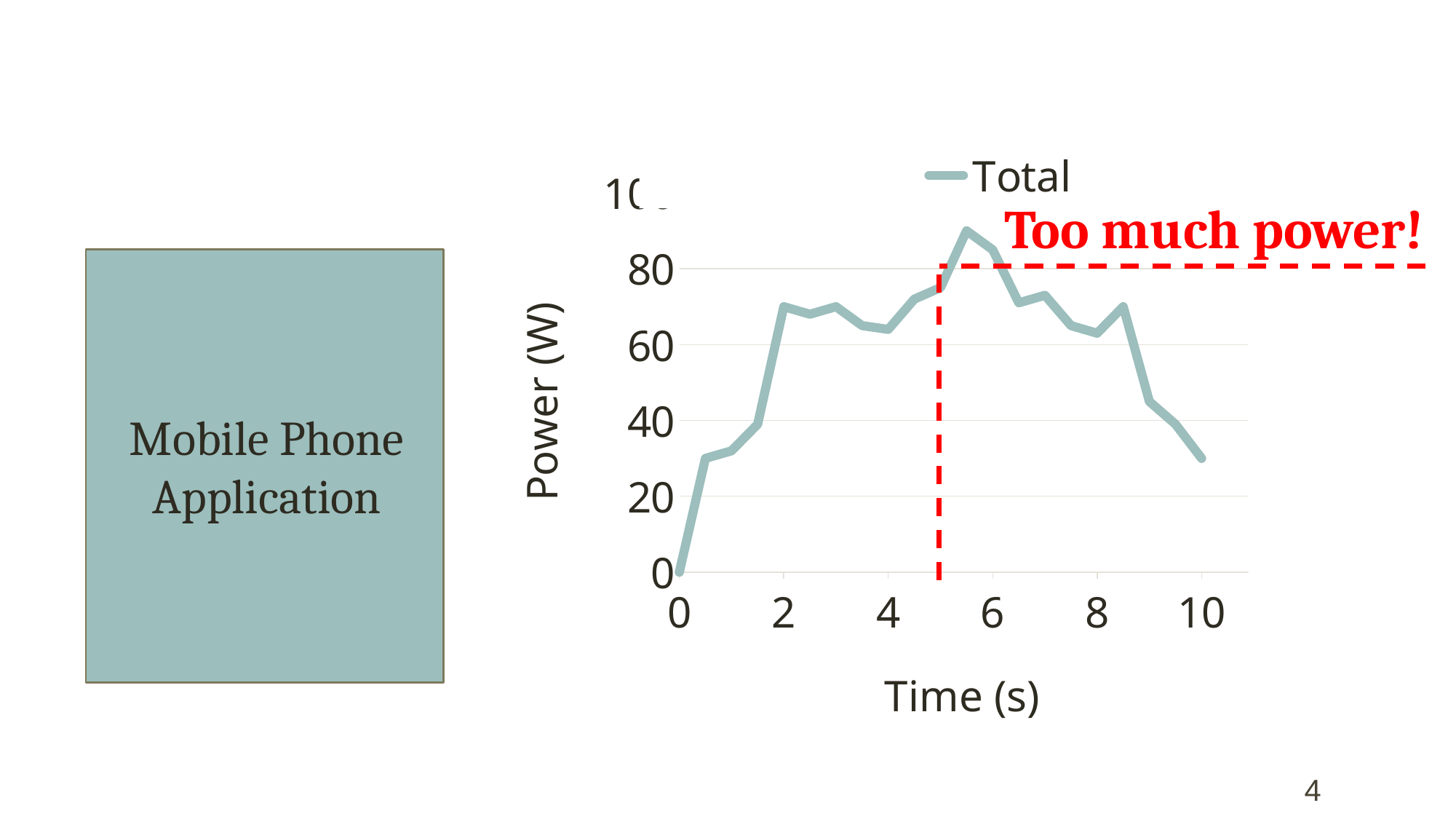
How many series does the chart's legend list? 1 What is the value of Total at time 0 s? 0 Between which two labeled x-axis ticks does the Total line reach its highest value? 4 and 6 Is the value of Total at time 10 s greater or less than 40? less What is the name of the series shown in the chart's legend? Total Does the Total line rise or fall between time 8 s and time 10 s? fall What kind of chart is shown on the slide? line chart Is the peak value of Total greater or less than 80? greater Does the Total line rise or fall between time 0 s and time 2 s? rise What is the label of the chart's vertical axis? Power (W) Is the value of Total at time 1 s greater or less than 20? greater